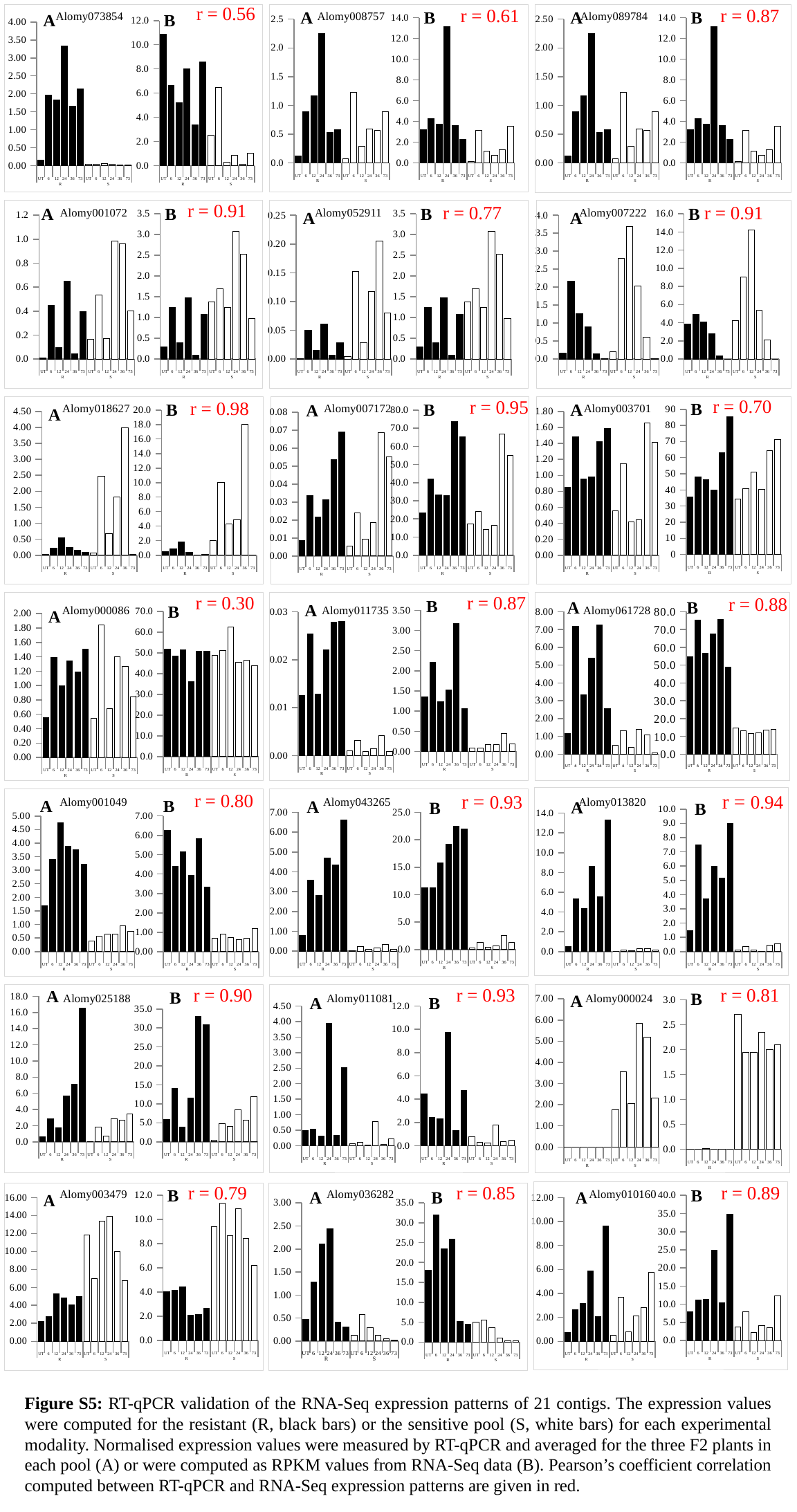
What kind of chart is used in panel A of Alomy073854? bar chart How many bars are plotted in panel A of Alomy073854? 12 How many contigs (chart pairs) are shown on the slide? 21 In panel B of Alomy018627, is the tallest bar greater or less than 16.0? greater In panel A of Alomy000024, is the tallest bar greater or less than 5.00? greater In panel A of Alomy000024, which pool has the taller bars, R or S? S In panel B of Alomy061728, which pool has the taller bars, R or S? R In panel A of Alomy073854, is the tallest bar greater or less than 3.00? greater What colour are the bars for the resistant pool (R) in these charts? black What Pearson correlation coefficient is printed in red for Alomy018627? r = 0.98 In panel A of Alomy025188, is the tallest bar black (R) or white (S)? black (R)